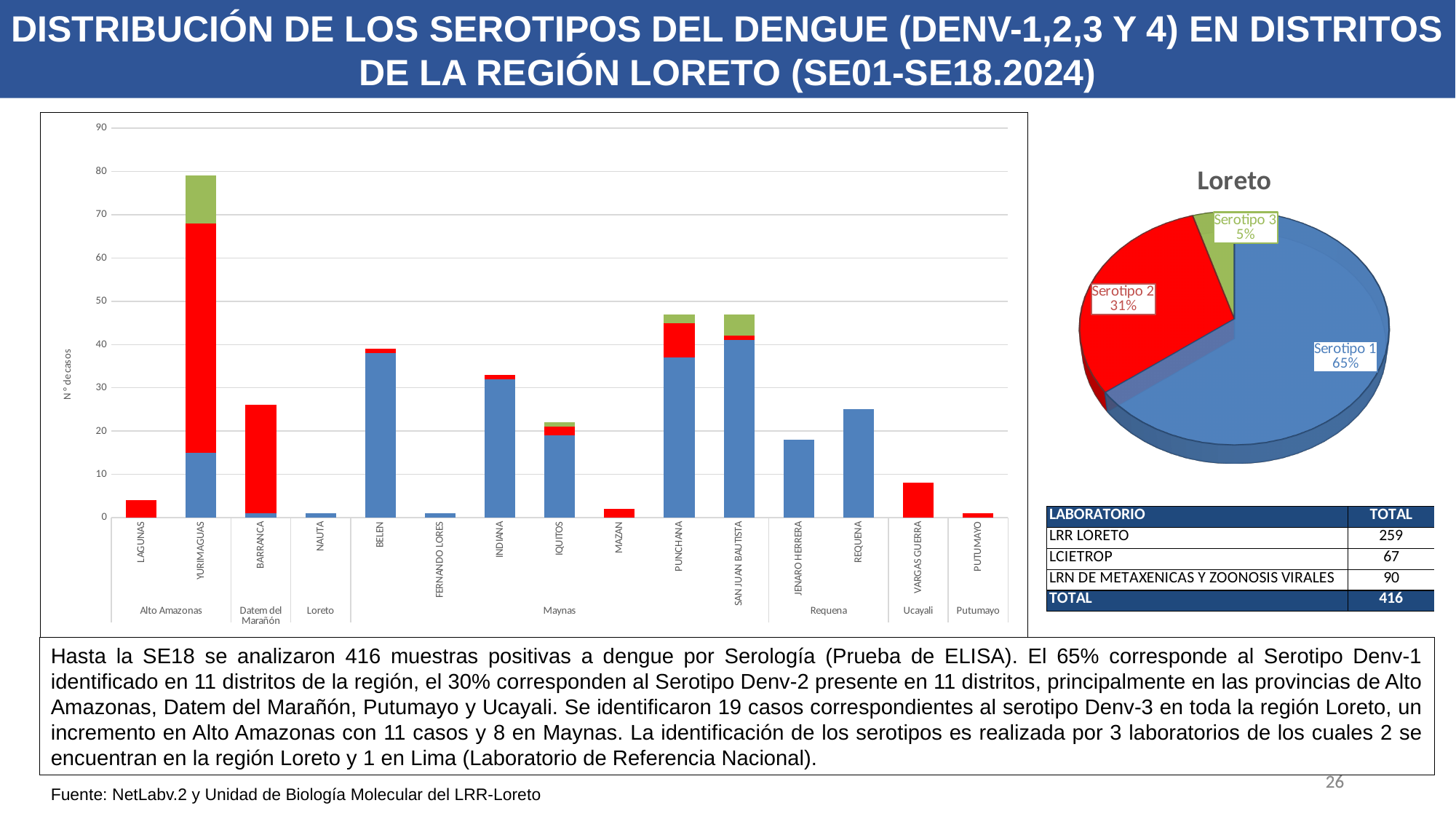
In the pie chart titled Loreto, what share is shown for Serotipo 2? 31% In the pie chart titled Loreto, what share is shown for Serotipo 1? 65% In the pie chart titled Loreto, which serotype has the smallest slice? Serotipo 3 What kind of chart is the large chart on the left showing cases by district? bar chart What kind of chart is the chart on the right titled Loreto? pie chart In the bar chart on the left, is the total value for Yurimaguas greater or less than 70? greater In the bar chart on the left, which district has more cases, Yurimaguas or Punchana? Yurimaguas How many slices does the pie chart titled Loreto have? 3 In the pie chart titled Loreto, which serotype has the largest slice? Serotipo 1 In the pie chart titled Loreto, what share is shown for Serotipo 3? 5% In the bar chart on the left, which district has the highest total number of cases? Yurimaguas In the pie chart titled Loreto, how many percentage points larger is the Serotipo 1 share than the Serotipo 2 share? 34%